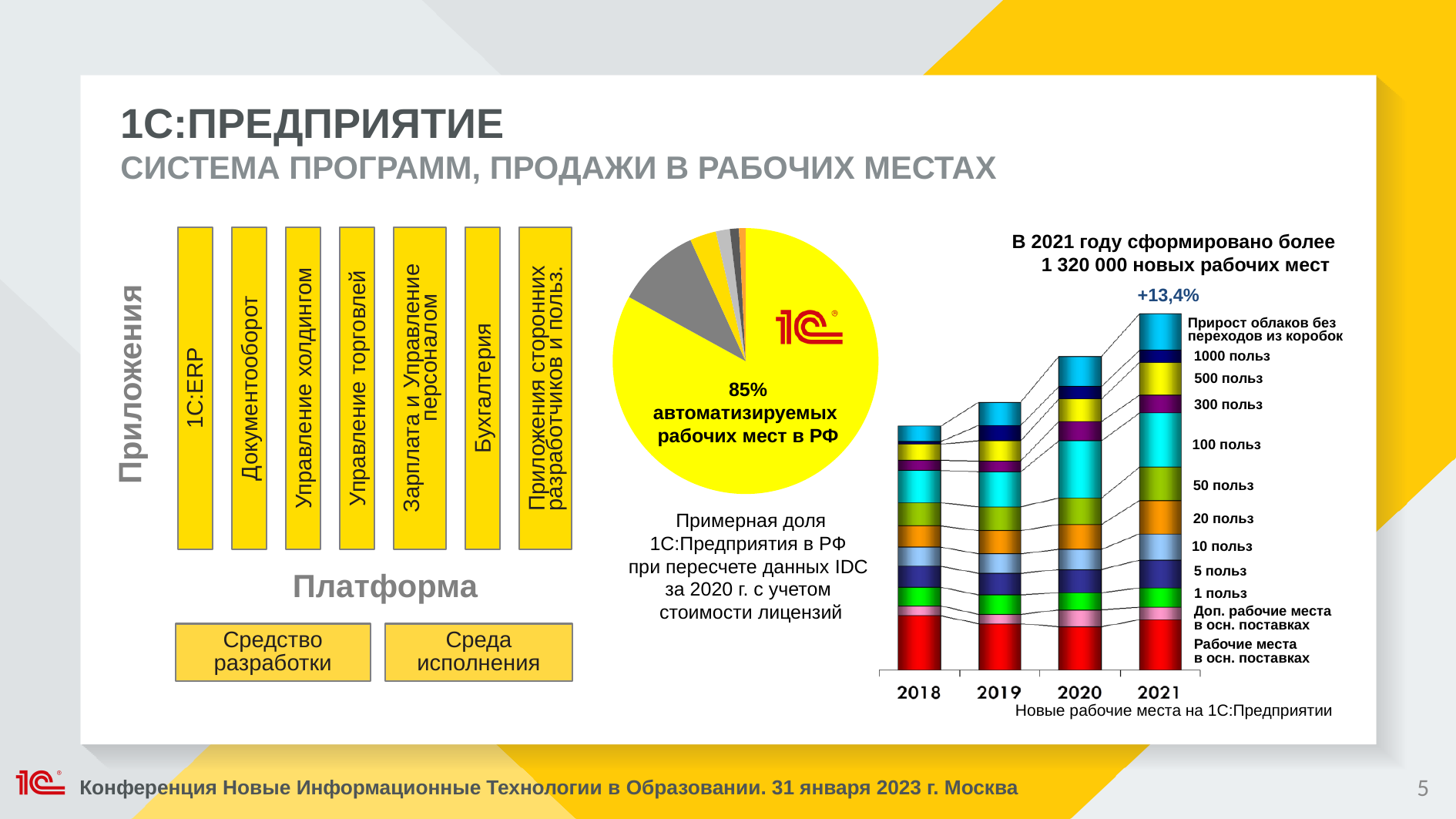
On the pie chart, what share of automated workplaces in Russia is attributed to 1C:Предприятие? 85% According to the heading above the bar chart, more than how many new workplaces were formed in 2021? 1 320 000 On the bar chart 'Новые рабочие места на 1С:Предприятии', which series is shown as the red segment at the bottom of each bar? Рабочие места в осн. поставках On the bar chart 'Новые рабочие места на 1С:Предприятии', how many years are shown on the x axis? 4 On the bar chart 'Новые рабочие места на 1С:Предприятии', how many series does the legend list? 12 On the bar chart 'Новые рабочие места на 1С:Предприятии', which year has the tallest bar? 2021 What kind of chart is the chart in the middle of the slide showing the 1C share? Pie chart On the bar chart 'Новые рабочие места на 1С:Предприятии', which year has the shortest bar? 2018 What kind of chart is the chart on the right titled 'Новые рабочие места на 1С:Предприятии'? Stacked bar chart On the bar chart 'Новые рабочие места на 1С:Предприятии', what growth percentage is printed above the 2021 bar? +13,4% On the bar chart 'Новые рабочие места на 1С:Предприятии', do the bar totals rise or fall from 2018 to 2021? Rise On the bar chart 'Новые рабочие места на 1С:Предприятии', which bar is taller, 2020 or 2021? 2021